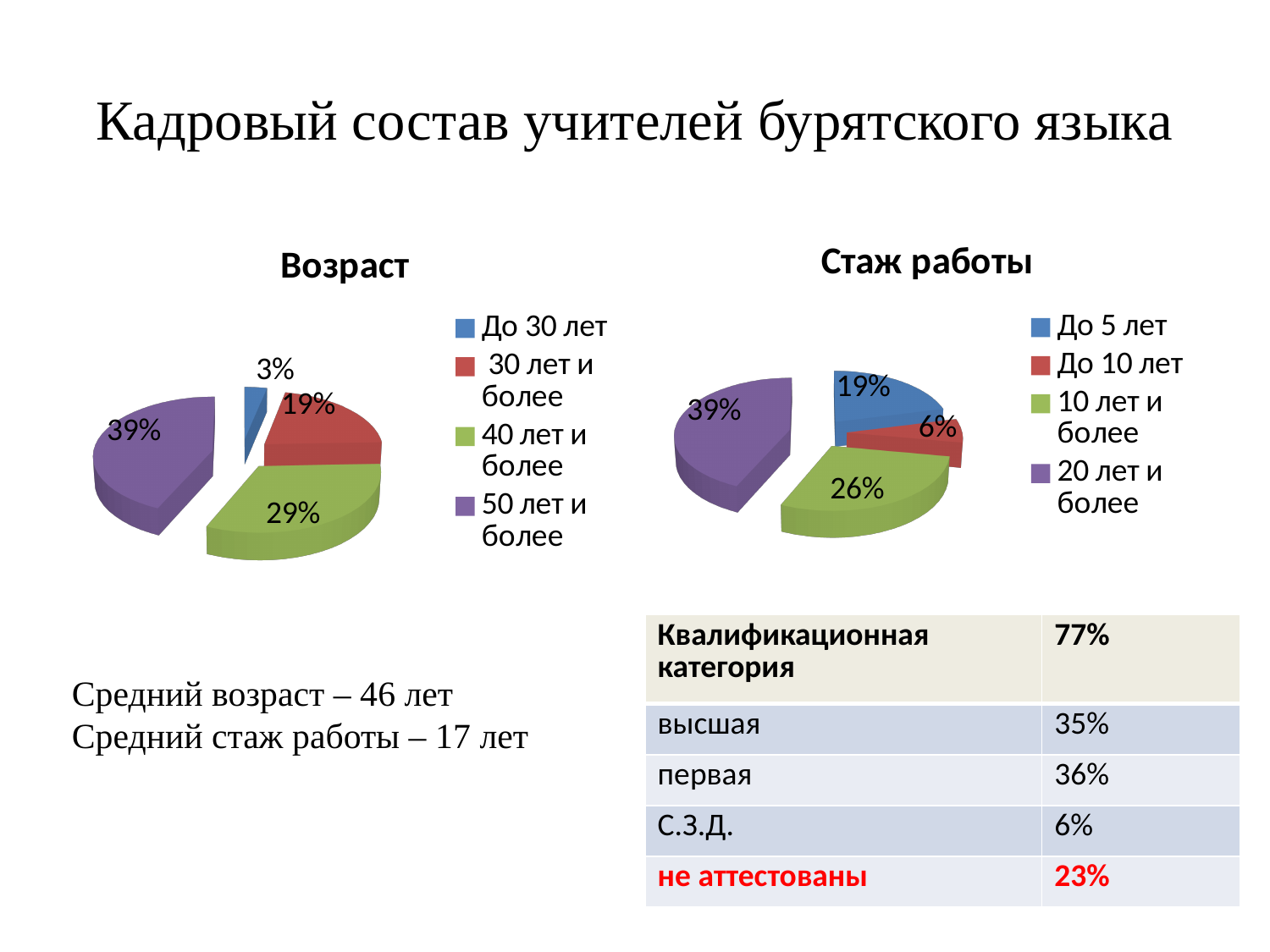
In the "Стаж работы" pie chart, which category has the largest share? 20 лет и более What type of chart is the "Возраст" chart? Pie chart In the "Возраст" pie chart, what colour is the "40 лет и более" slice? Green In the "Возраст" pie chart, what share is shown for "До 30 лет"? 3% In the "Стаж работы" pie chart, what share is shown for "10 лет и более"? 26% In the "Стаж работы" pie chart, what share is shown for "До 10 лет"? 6% In the "Возраст" pie chart, what share is shown for "50 лет и более"? 39% How many categories does the legend of the "Стаж работы" chart list? 4 In the "Стаж работы" pie chart, which is larger: "До 5 лет" or "До 10 лет"? До 5 лет In the "Возраст" pie chart, which category has the smallest share? До 30 лет In the "Возраст" pie chart, what is the difference between the shares for "40 лет и более" and "30 лет и более"? 10% In the "Возраст" pie chart, which category has the largest share? 50 лет и более